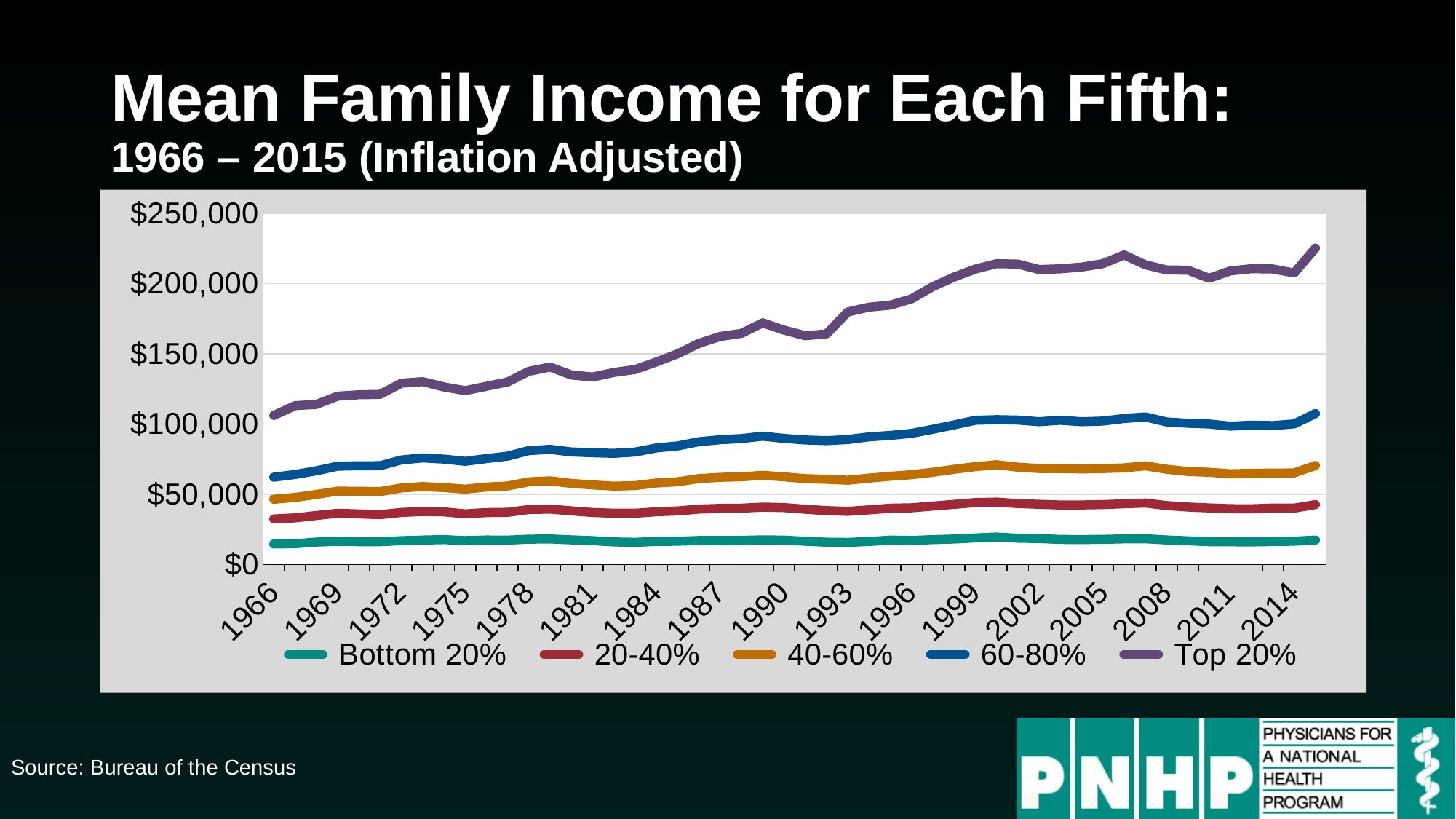
How many series does the legend list? 5 How many year labels are shown on the x axis? 17 Is the value for Bottom 20% in 2015 greater or less than $50,000? less Is the value for 20-40% in 1999 greater or less than $50,000? less Which series has the highest values across the whole period? Top 20% Is the value for Top 20% in 2015 greater or less than $200,000? greater Which is larger in 2015, the value for 60-80% or the value for 40-60%? 60-80% Which series has the lowest values across the whole period? Bottom 20% What kind of chart is shown on the slide? line chart What is the title of the chart on the slide? Mean Family Income for Each Fifth: 1966 – 2015 (Inflation Adjusted) Does the Top 20% line generally rise or fall from 1966 to 2015? rise